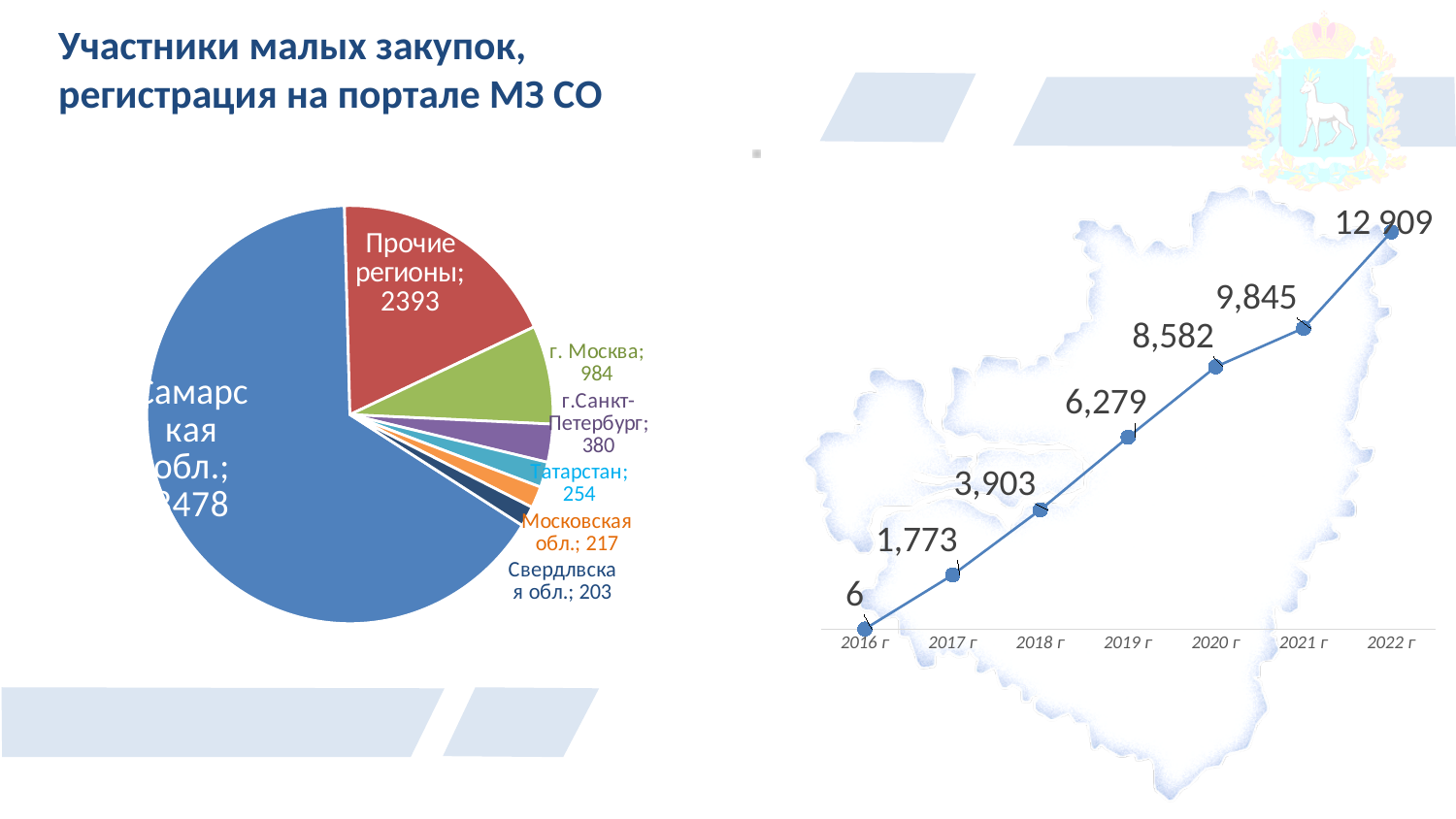
On the line chart on the right, do the values rise or fall from 2016 г to 2022 г? rise On the line chart on the right, which year has the highest value? 2022 г On the pie chart on the left, which is larger, Татарстан or Московская обл.? Татарстан On the line chart on the right, which year has the lowest value? 2016 г On the pie chart on the left, what is the value for г. Москва? 984 On the line chart on the right, how many years are plotted? 7 On the line chart on the right, what is the difference between the values for 2022 г and 2021 г? 3,064 On the pie chart on the left, what is the difference between the values for г. Москва and г.Санкт-Петербург? 604 On the pie chart on the left, what is the value for Прочие регионы? 2393 On the line chart on the right, what is the value for 2019 г? 6,279 On the line chart on the right, what is the value for 2022 г? 12 909 What kind of chart is the chart on the right of the slide? line chart